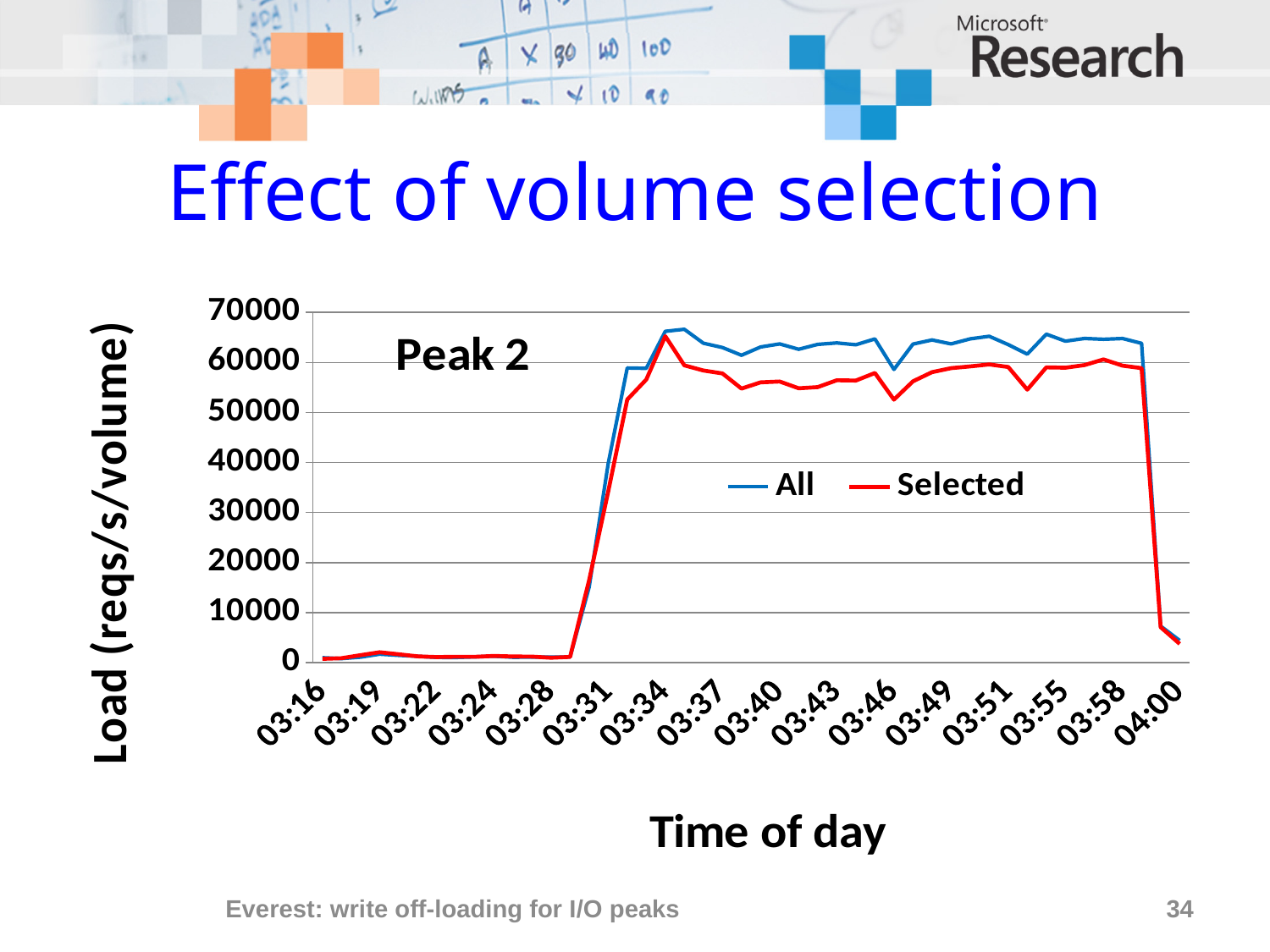
Is the value of the Selected series at 03:40 greater or less than 60000? less Is the value of the All series at 03:22 greater or less than 10000? less At 03:40, which series has the higher value, All or Selected? All Is the value of the All series at 03:40 greater or less than 60000? greater Do the values of the Selected series rise or fall between 03:58 and 04:00? fall Do the values of the All series rise or fall between 03:28 and 03:34? rise What are the two series named in the chart legend? All and Selected What kind of chart is shown on the slide? line chart How many series does the chart legend list? 2 What is the y-axis title of the chart? Load (reqs/s/volume) At 03:46, which series has the higher value, All or Selected? All